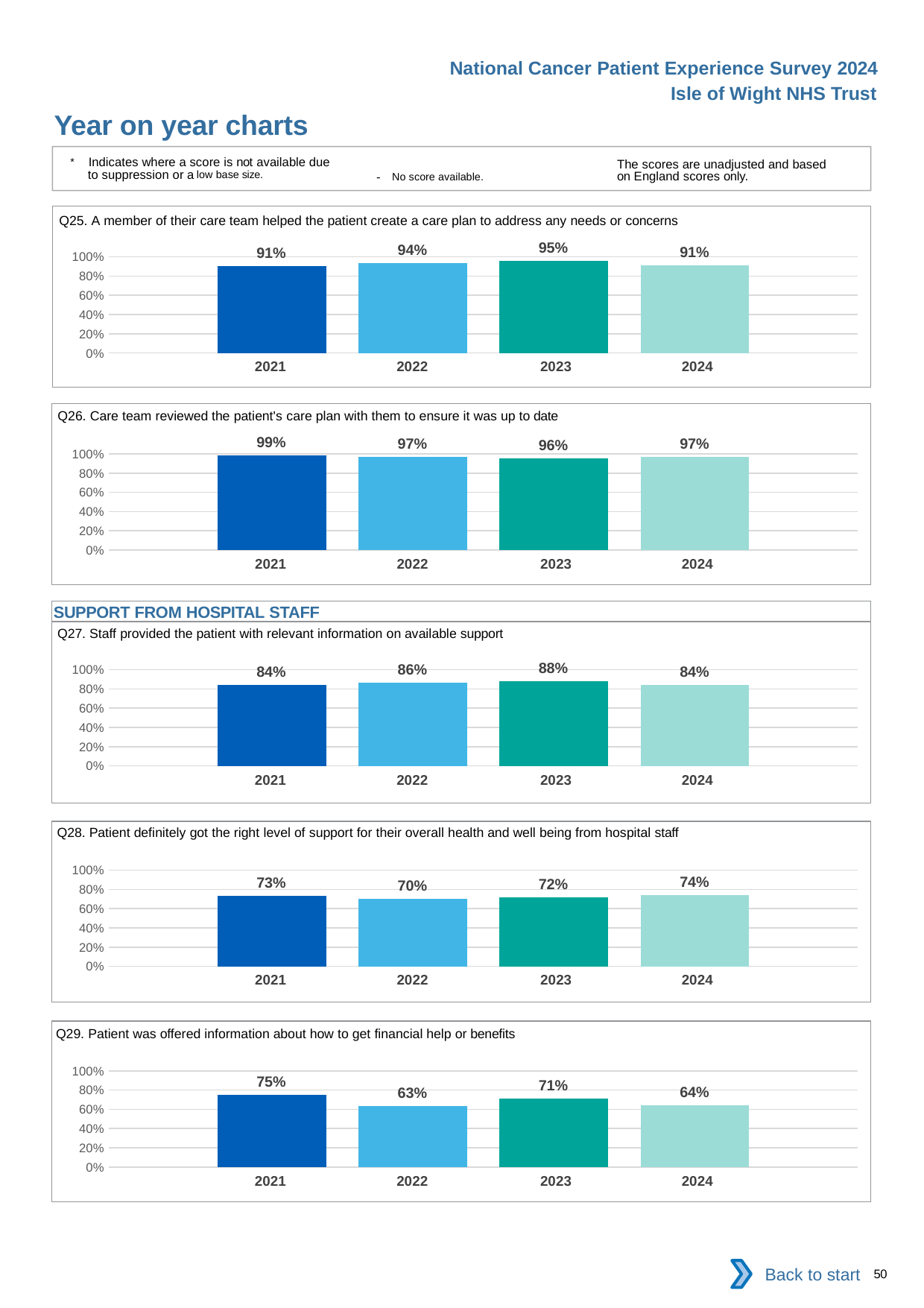
What kind of chart is the Q25 chart? Bar chart In the Q28 chart, which is larger, the value for 2021 or the value for 2024? 2024 In the Q27 chart, which year has the highest value? 2023 How many years are shown in the Q29 chart? 4 In the Q25 chart, which year has the highest value? 2023 In the Q25 chart, what is the value for 2023? 95% In the Q26 chart, which year has the lowest value? 2023 In the Q28 chart, what is the value for 2022? 70% In the Q29 chart, what is the difference between the 2021 and 2022 values? 12 percentage points In the Q27 chart, what is the difference between the 2023 and 2024 values? 4 percentage points In the Q26 chart, what is the value for 2021? 99% In the Q29 chart, which year has the lowest value? 2022